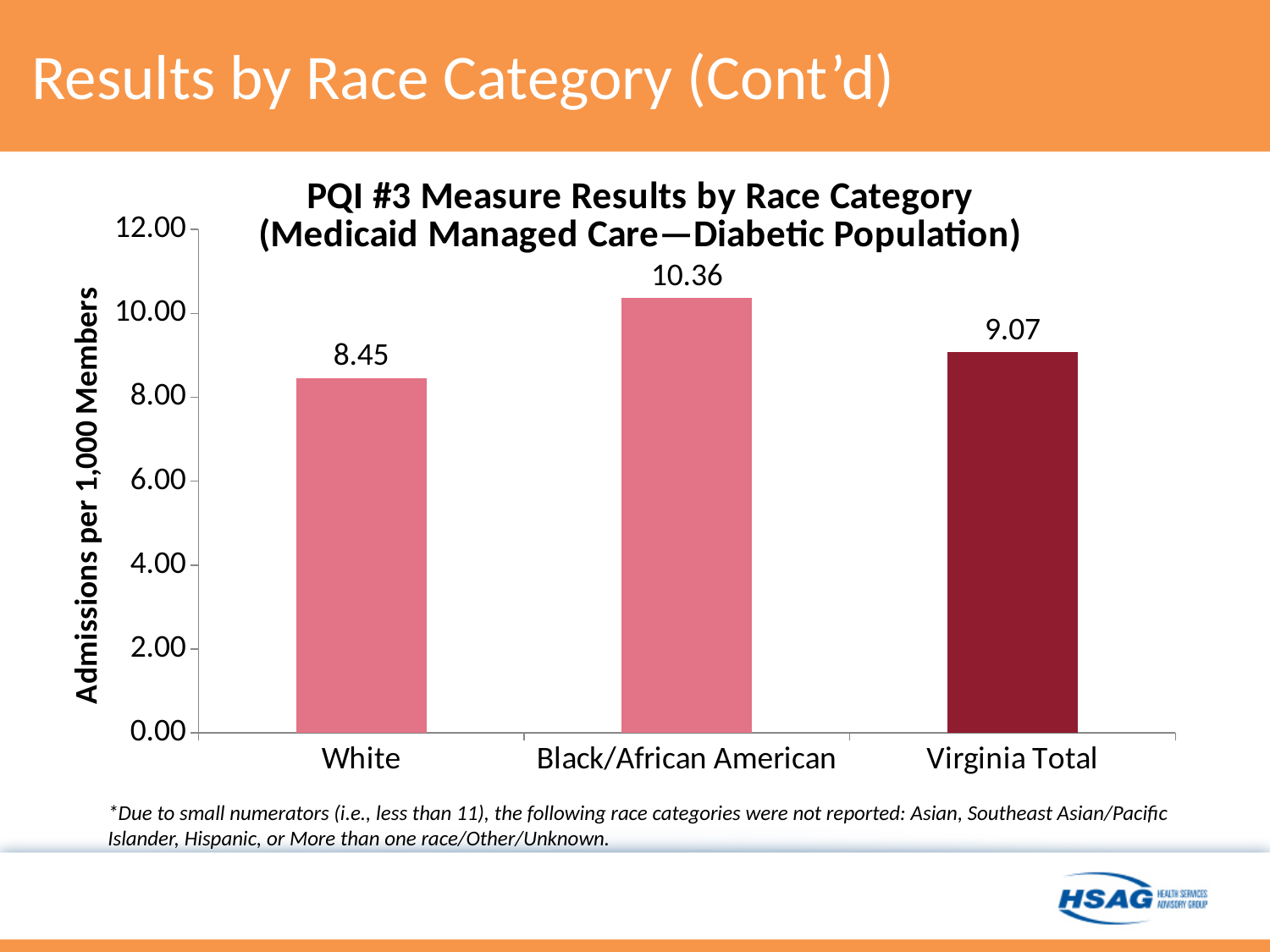
What is the value for White? 8.45 How many categories are shown on the x axis? 3 What is the label of the y axis? Admissions per 1,000 Members Which category has the lowest value? White What is the value for Black/African American? 10.36 Is the value for Black/African American greater or less than 10.00? greater What is the value for Virginia Total? 9.07 What is the difference between the values for Black/African American and White? 1.91 What kind of chart is shown on the slide? bar chart Which is larger, the value for Virginia Total or the value for White? Virginia Total What is the difference between the values for Virginia Total and White? 0.62 Which category has the highest value? Black/African American